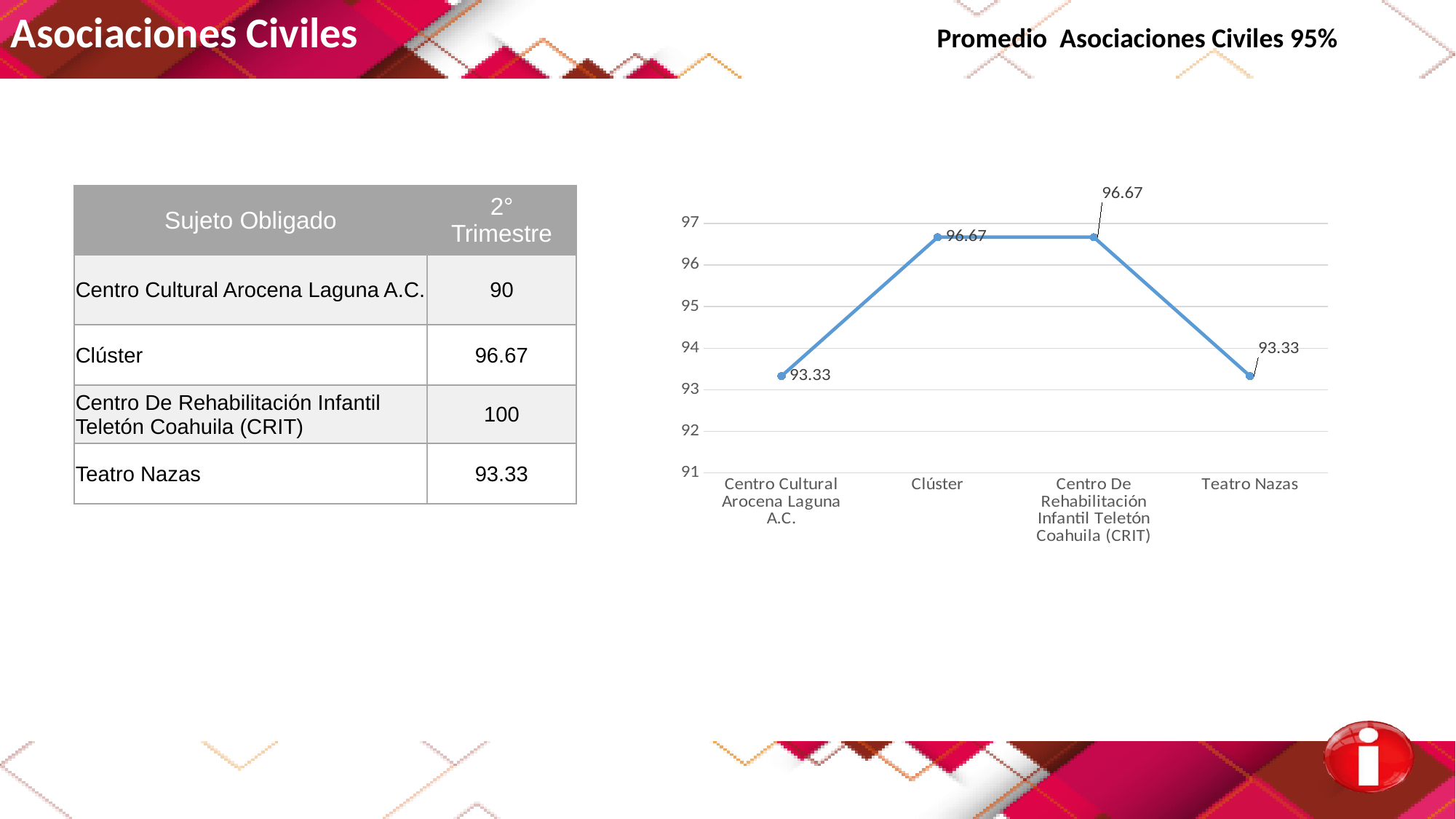
How many categories are plotted on the chart? 4 What value does the chart show for Clúster? 96.67 What value does the chart show for Teatro Nazas? 93.33 Is the chart value for Centro De Rehabilitación Infantil Teletón Coahuila (CRIT) greater or less than 96? greater What kind of chart is shown on the slide? line chart What value does the chart show for Centro De Rehabilitación Infantil Teletón Coahuila (CRIT)? 96.67 What is the difference between the chart values for Clúster and Teatro Nazas? 3.34 Which is larger in the chart, the value for Clúster or the value for Centro Cultural Arocena Laguna A.C.? Clúster Is the chart value for Teatro Nazas greater or less than 95? less What value does the chart show for Centro Cultural Arocena Laguna A.C.? 93.33 Does the line rise or fall between Centro Cultural Arocena Laguna A.C. and Clúster? rise What is the lowest value shown on the chart's vertical axis? 91